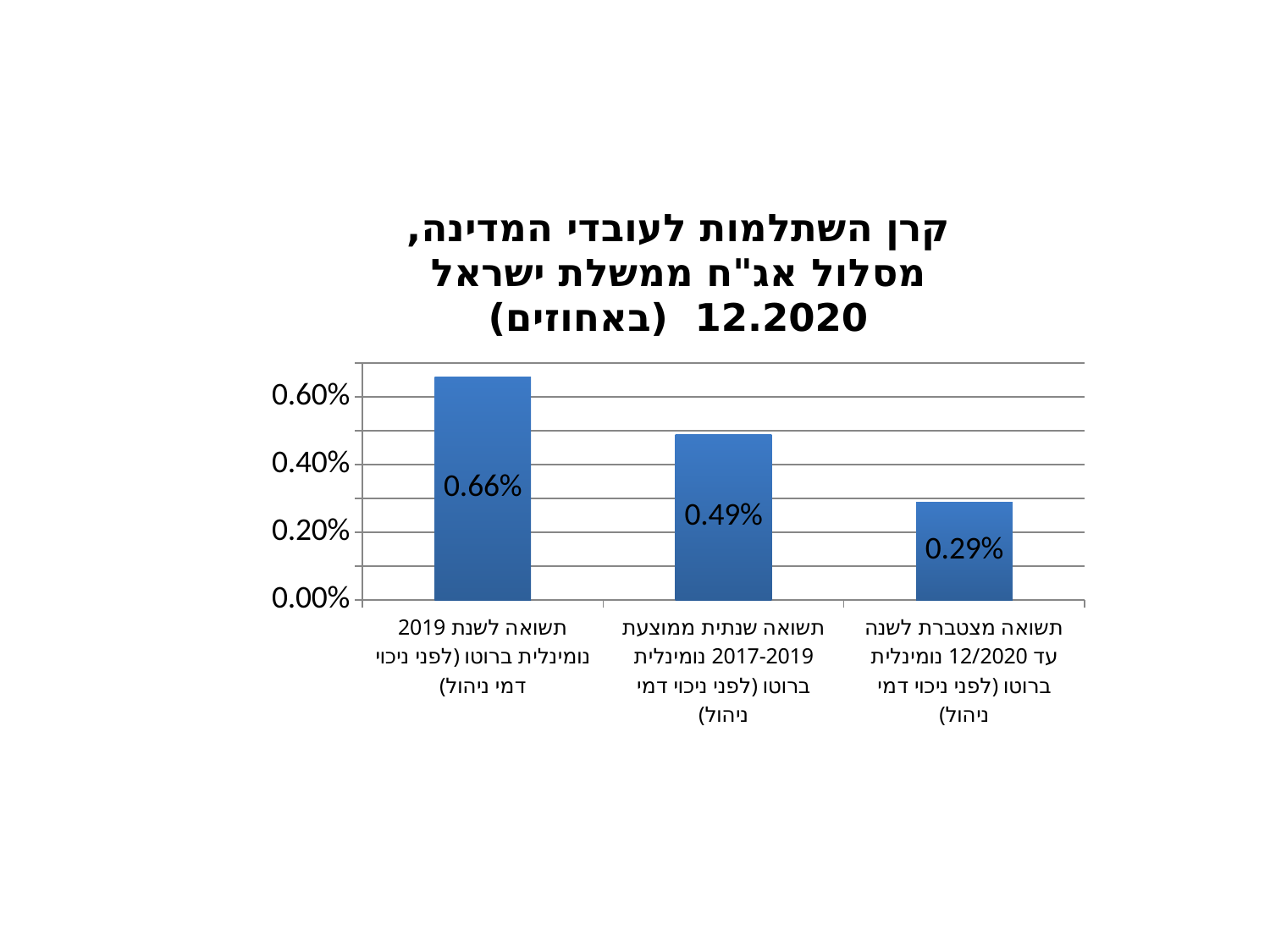
What is the value of the bar labelled "תשואה מצטברת לשנה עד 12/2020 נומינלית ברוטו" (cumulative return for the year to 12/2020)? 0.29% Which category has the highest value in the chart? תשואה לשנת 2019 נומינלית ברוטו (לפני ניכוי דמי ניהול) What is the title of the chart? קרן השתלמות לעובדי המדינה, מסלול אג"ח ממשלת ישראל 12.2020 (באחוזים) What kind of chart is shown on the slide? Bar chart Which is larger: the average annual return for 2017-2019 or the cumulative return to 12/2020? The average annual return for 2017-2019 (0.49%) What is the value of the bar labelled "תשואה לשנת 2019 נומינלית ברוטו (לפני ניכוי דמי ניהול)" (nominal gross return for 2019)? 0.66% How many bars are shown in the chart? 3 What is the difference between the 2019 return (0.66%) and the cumulative return to 12/2020 (0.29%)? 0.37% Which category has the lowest value in the chart? תשואה מצטברת לשנה עד 12/2020 נומינלית ברוטו (לפני ניכוי דמי ניהול) Is the value for the cumulative return to 12/2020 greater or less than 0.40%? less What is the difference between the 2019 return and the average annual return for 2017-2019? 0.17% What is the value of the bar labelled "תשואה שנתית ממוצעת 2017-2019 נומינלית ברוטו" (average annual nominal gross return 2017-2019)? 0.49%